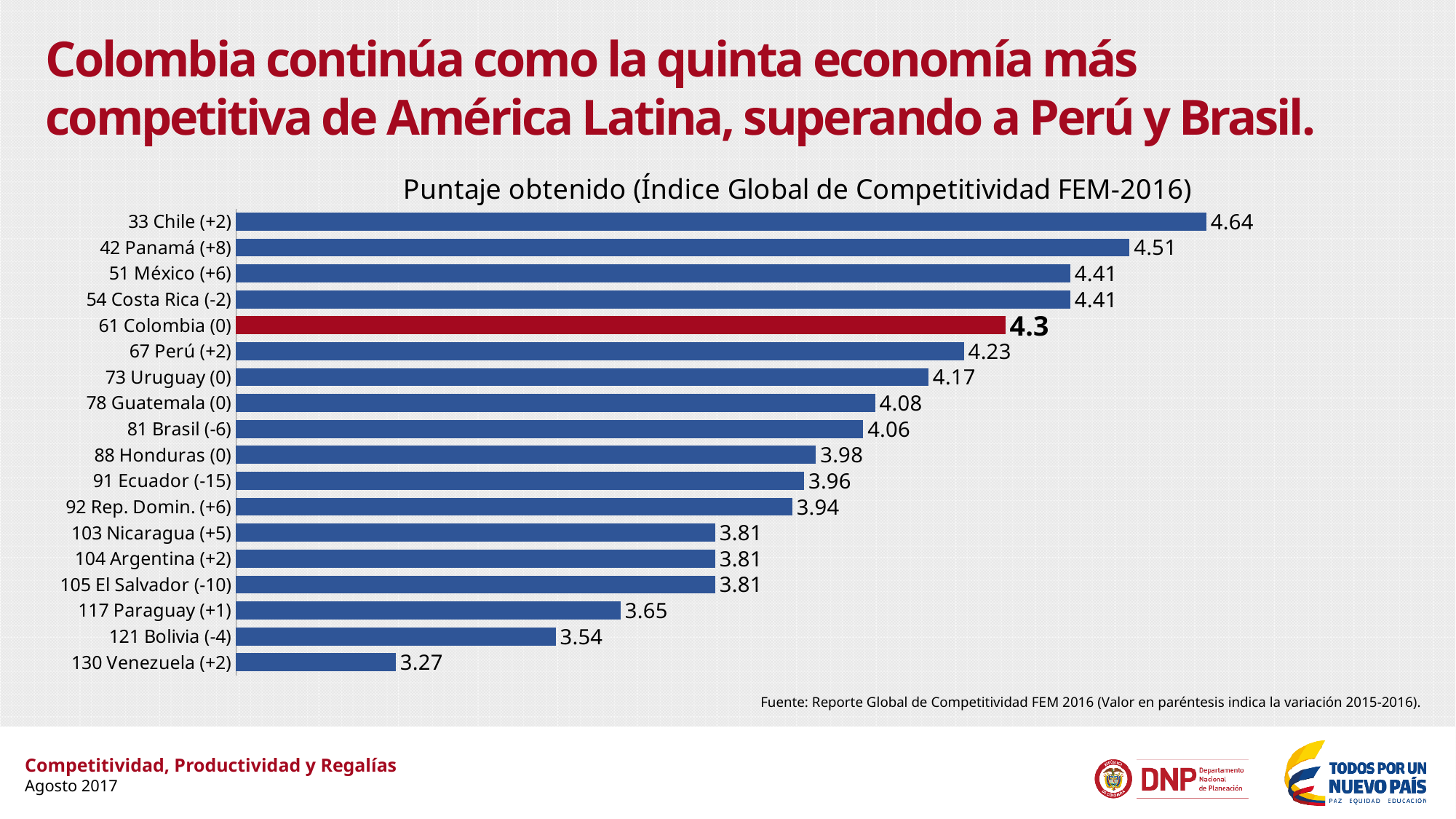
Which country has the highest score in the chart? 33 Chile (+2) Which has a higher score, 42 Panamá (+8) or 73 Uruguay (0)? 42 Panamá (+8) What is the difference between the scores of 61 Colombia (0) and 81 Brasil (-6)? 0.24 What is the score shown for 61 Colombia (0)? 4.3 What is the title of the chart? Puntaje obtenido (Índice Global de Competitividad FEM-2016) What is the score shown for 130 Venezuela (+2)? 3.27 What is the score shown for 67 Perú (+2)? 4.23 What is the difference between the scores of 33 Chile (+2) and 130 Venezuela (+2)? 1.37 How many countries are shown in the chart? 18 What type of chart is shown on the slide? Bar chart Which country has the lowest score in the chart? 130 Venezuela (+2) Which country's bar is highlighted in red in the chart? 61 Colombia (0)